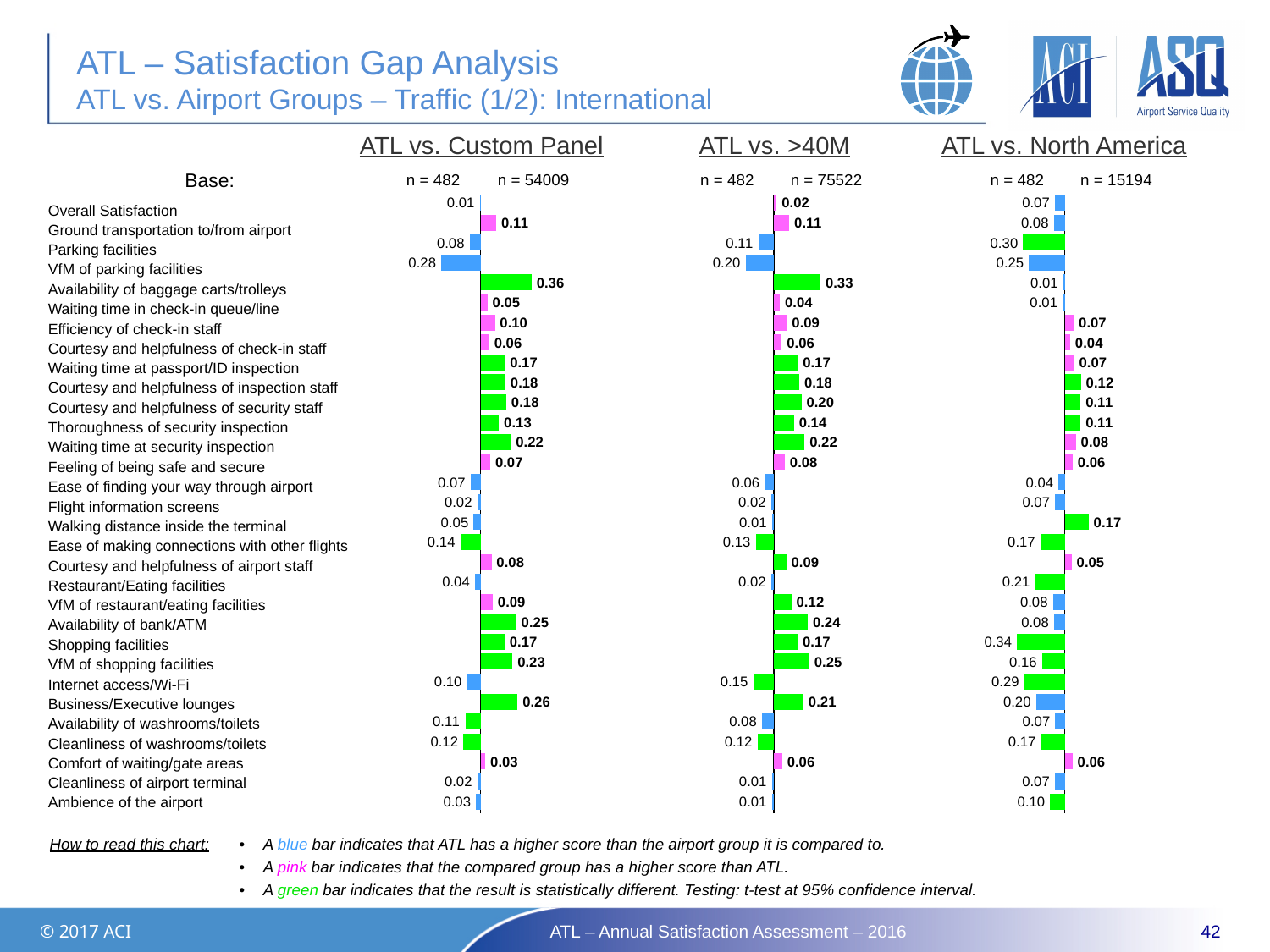
In the ATL vs. Custom Panel chart, what is the value for Waiting time at security inspection? 0.22 In the ATL vs. North America chart, what is the value for Shopping facilities? 0.34 In the ATL vs. North America chart, which is larger: the value for Parking facilities or the value for Internet access/Wi-Fi? Parking facilities What kind of chart is used for ATL vs. >40M? Bar chart In the ATL vs. Custom Panel chart, which category has the largest gap value? Availability of baggage carts/trolleys In the ATL vs. >40M chart, what is the difference between the values for Availability of baggage carts/trolleys and VfM of shopping facilities? 0.08 What is the sample size (n) of the airport group in the ATL vs. North America chart? n = 15194 In the ATL vs. >40M chart, what is the value for Business/Executive lounges? 0.21 In the ATL vs. Custom Panel chart, what is the value for Availability of baggage carts/trolleys? 0.36 According to the slide, what does a green bar indicate? The result is statistically different In the ATL vs. Custom Panel chart, which is larger: the value for VfM of parking facilities or the value for Business/Executive lounges? VfM of parking facilities In the ATL vs. North America chart, which category has the largest gap value? Shopping facilities